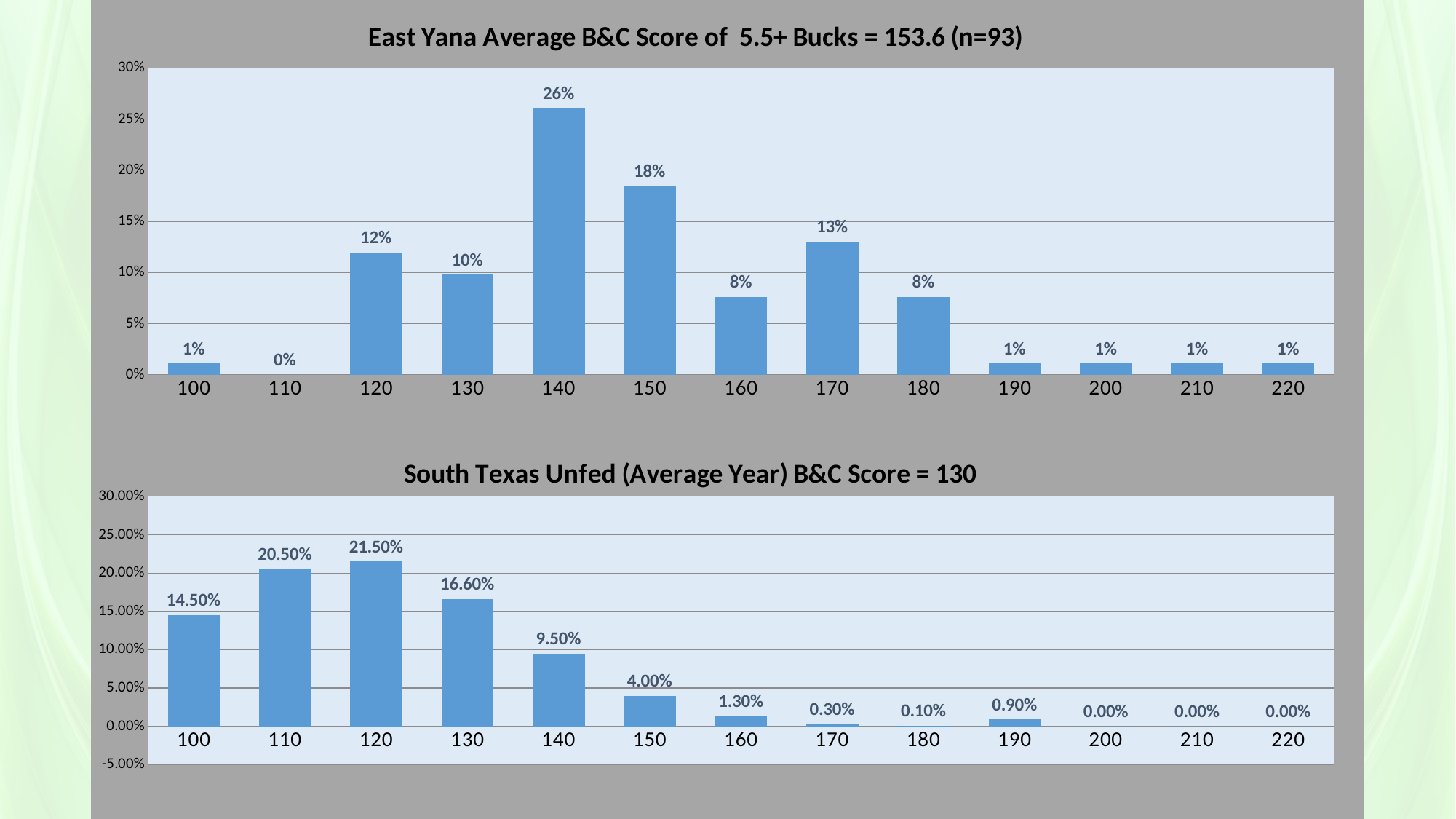
In the East Yana chart, which category has the highest value? 140 In the East Yana chart, how many categories are shown on the x axis? 13 In the East Yana chart, what is the value for the 140 category? 26% In the South Texas Unfed chart, what is the value for the 120 category? 21.50% What type of chart is the top chart on the slide? bar chart In the South Texas Unfed chart, what is the difference between the values for 110 and 130? 3.90% In the East Yana chart, which is larger, the value for 120 or the value for 130? 120 In the South Texas Unfed chart, which category has the highest value? 120 In the South Texas Unfed chart, do the values generally rise or fall from 120 to 180 along the x axis? fall In the South Texas Unfed chart, is the value for 100 greater or less than 10.00%? greater In the East Yana chart, what is the difference between the values for 140 and 150? 8% In the East Yana chart, which category has the lowest value? 110